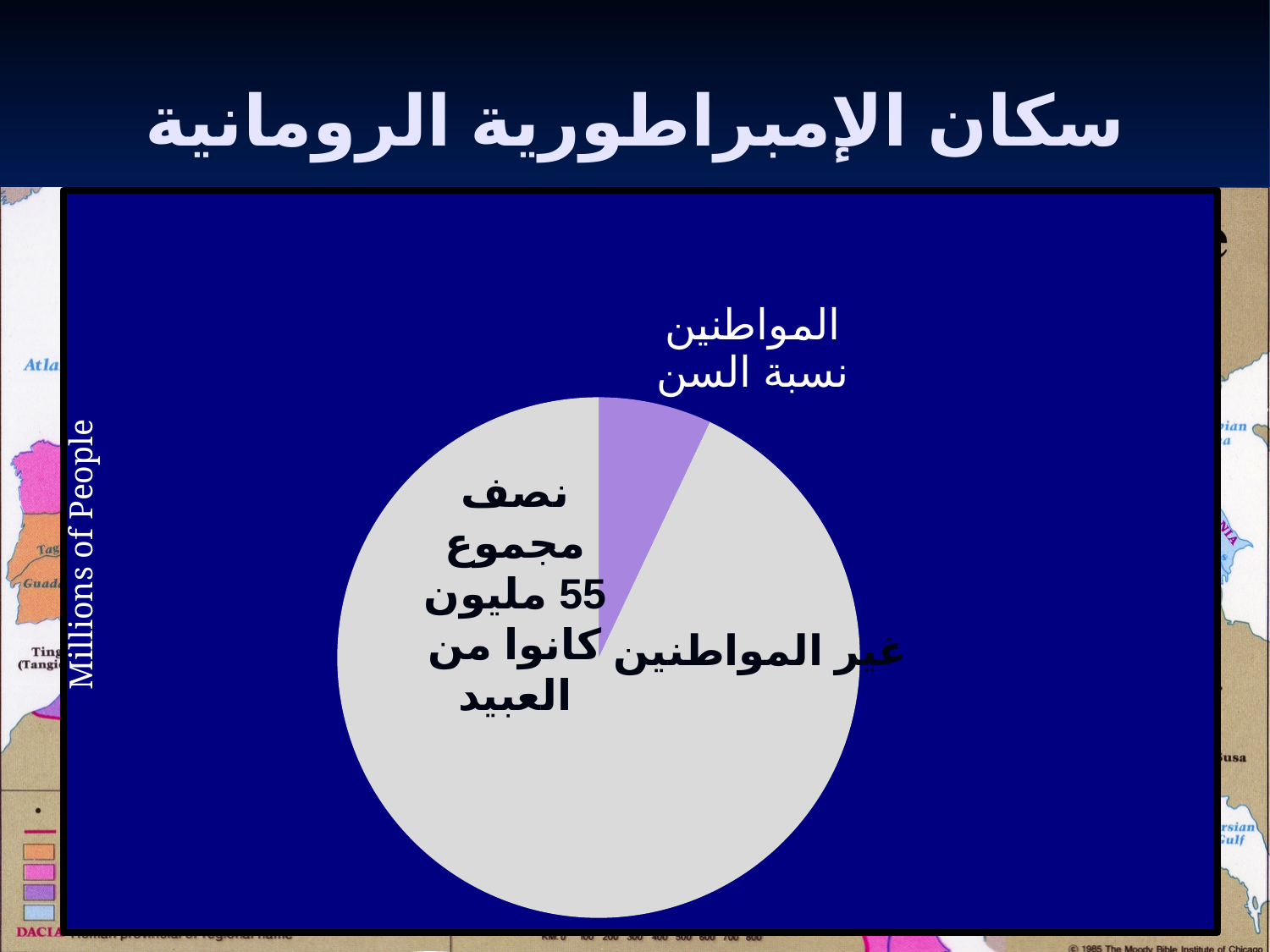
Which slice of the pie chart is the largest? غير المواطنين Which slice is larger, المواطنين or غير المواطنين? غير المواطنين What is the title of the slide containing the pie chart? سكان الإمبراطورية الرومانية What kind of chart is shown on the slide? pie chart How many slices does the pie chart have? 2 What colour is the slice for غير المواطنين in the pie chart? grey Which slice of the pie chart is the smallest? المواطنين